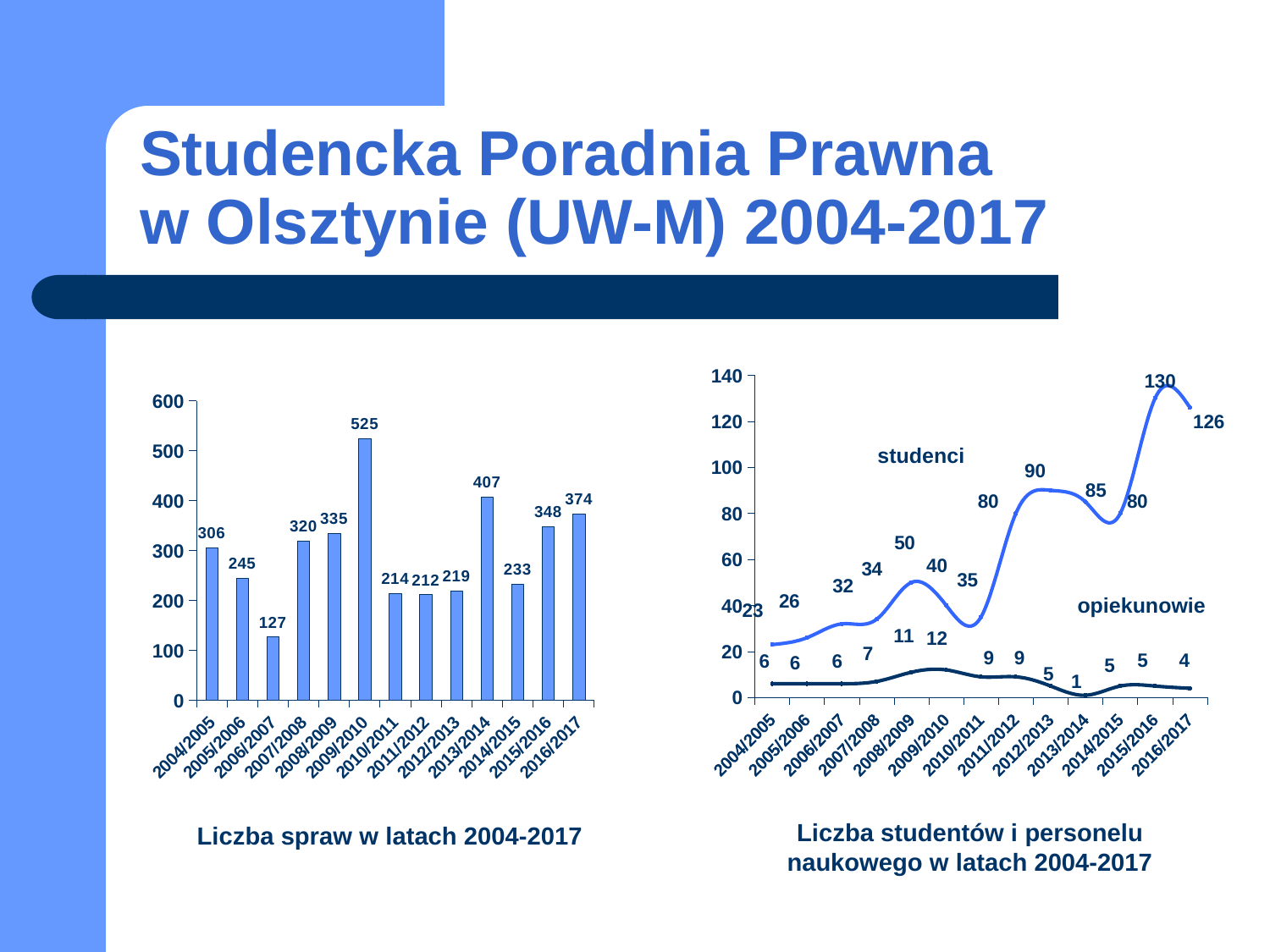
What kind of chart is the chart titled "Liczba studentów i personelu naukowego w latach 2004-2017"? line chart In the chart titled "Liczba spraw w latach 2004-2017", how many years are shown on the x axis? 13 What kind of chart is the chart titled "Liczba spraw w latach 2004-2017"? bar chart In the chart titled "Liczba studentów i personelu naukowego w latach 2004-2017", what is the value for studenci in 2015/2016? 130 In the chart titled "Liczba studentów i personelu naukowego w latach 2004-2017", in which year does the opiekunowie series reach its highest value? 2009/2010 In the chart titled "Liczba spraw w latach 2004-2017", which is larger, the value for 2004/2005 or the value for 2005/2006? 2004/2005 In the chart titled "Liczba spraw w latach 2004-2017", which year has the lowest value? 2006/2007 In the chart titled "Liczba spraw w latach 2004-2017", what is the difference between the values for 2013/2014 and 2014/2015? 174 In the chart titled "Liczba studentów i personelu naukowego w latach 2004-2017", how many series are plotted? 2 In the chart titled "Liczba spraw w latach 2004-2017", what is the value for 2009/2010? 525 In the chart titled "Liczba studentów i personelu naukowego w latach 2004-2017", what is the difference between studenci and opiekunowie in 2016/2017? 122 In the chart titled "Liczba studentów i personelu naukowego w latach 2004-2017", what is the value for opiekunowie in 2013/2014? 1